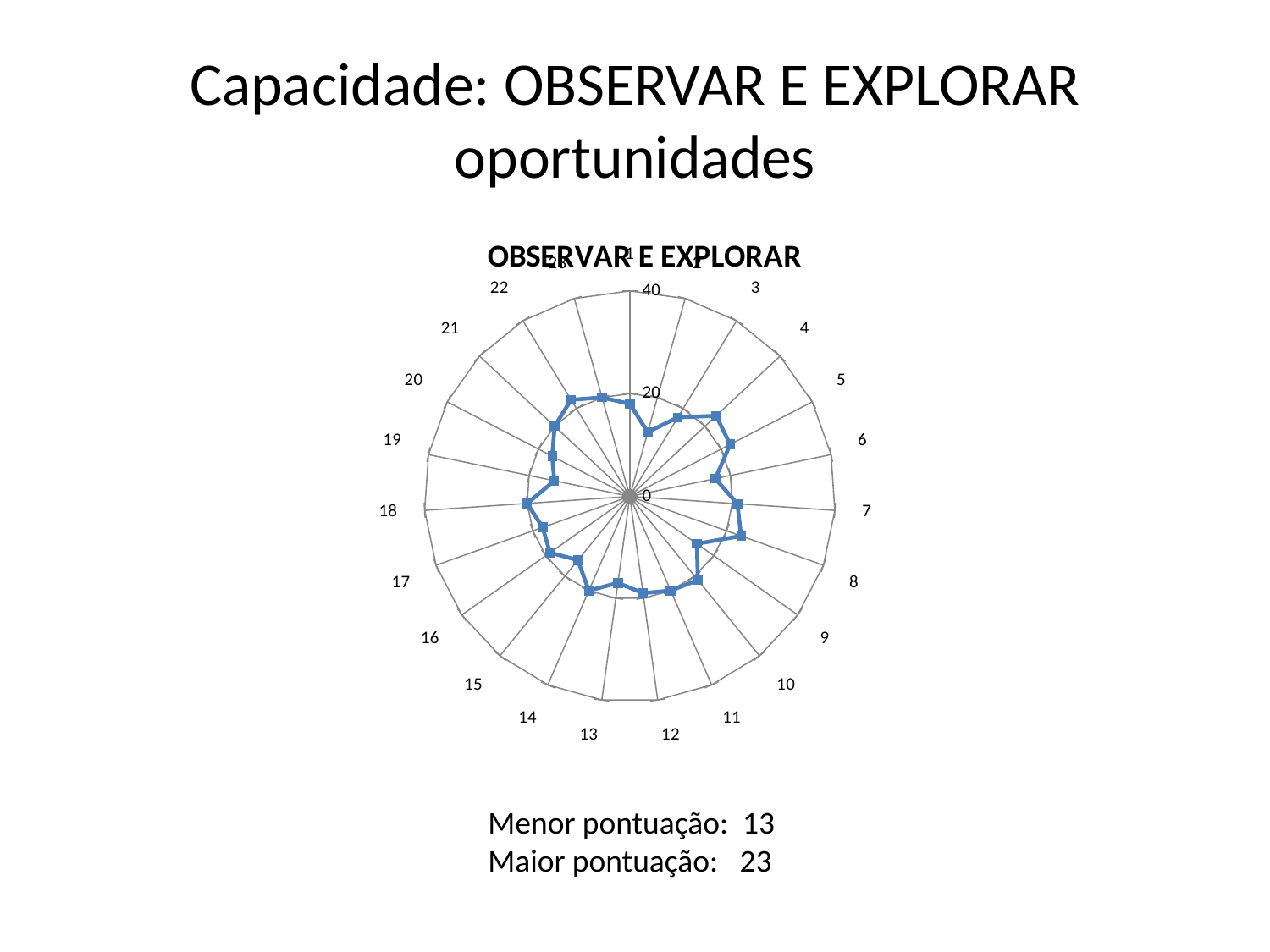
Which category has the lowest value on the radar chart? 2 Is the value for category 2 greater or less than 20? less Is the value for category 8 greater or less than 20? greater Is the value for category 19 greater or less than 20? less What kind of chart is shown on the slide? radar chart According to the text below the chart, what is the 'Menor pontuação' (lowest score)? 13 What is the title of the chart? OBSERVAR E EXPLORAR Which has the larger value, category 8 or category 2? category 8 How many categories are plotted around the radar chart? 23